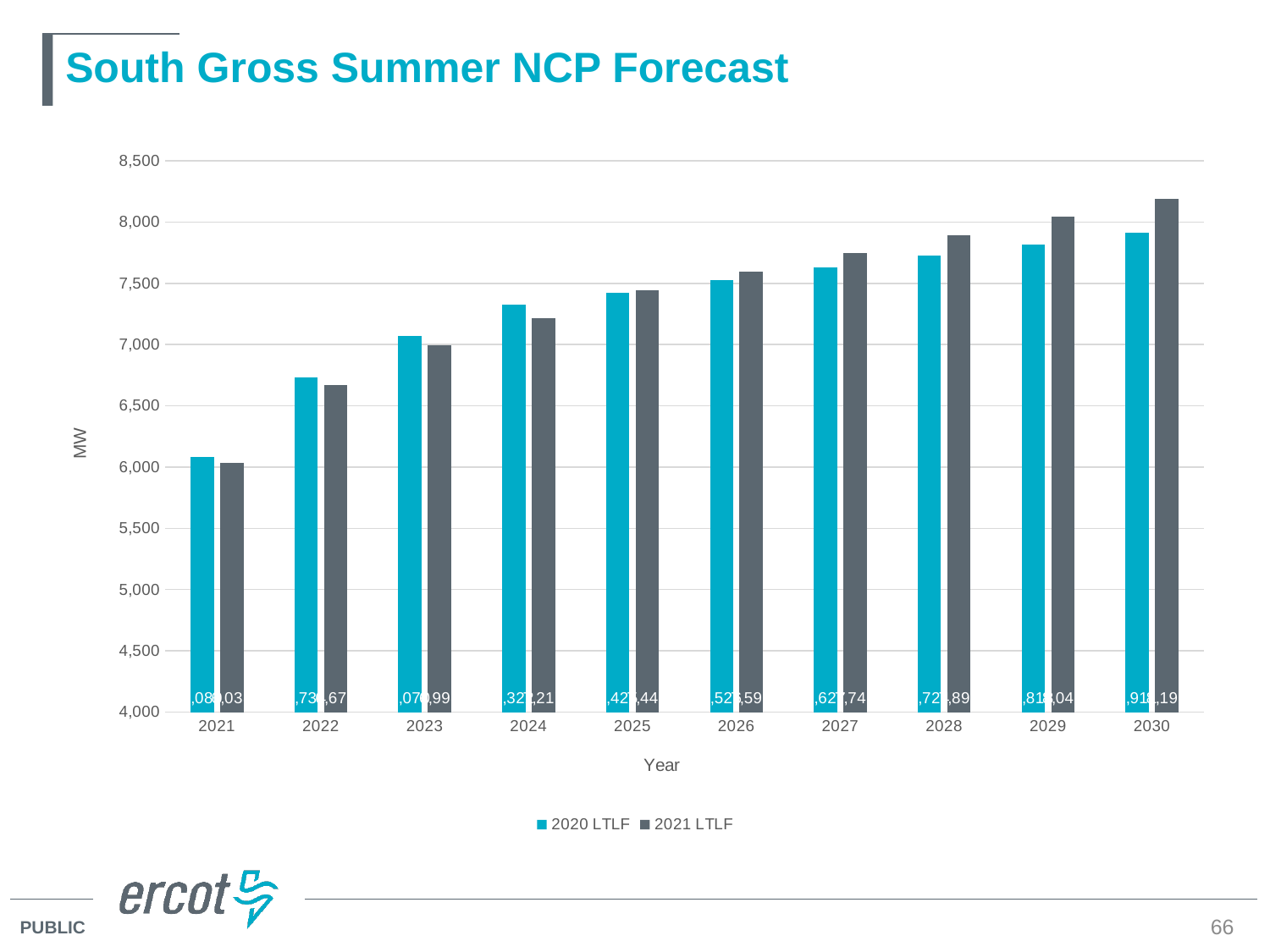
Which year has the highest 2021 LTLF value? 2030 What kind of chart is shown on the slide? bar chart How many series does the legend list? 2 Is the 2021 LTLF value for 2030 greater or less than 8,000? greater Do the 2021 LTLF values rise or fall from 2021 to 2030? rise What is the label on the y axis? MW Is the 2020 LTLF value for 2021 greater or less than 6,500? less Which year has the lowest 2020 LTLF value? 2021 How many years are shown on the x axis? 10 In 2021, which series has the larger value, 2020 LTLF or 2021 LTLF? 2020 LTLF In 2030, which series has the larger value, 2020 LTLF or 2021 LTLF? 2021 LTLF Is the 2020 LTLF value for 2030 greater or less than 8,000? less